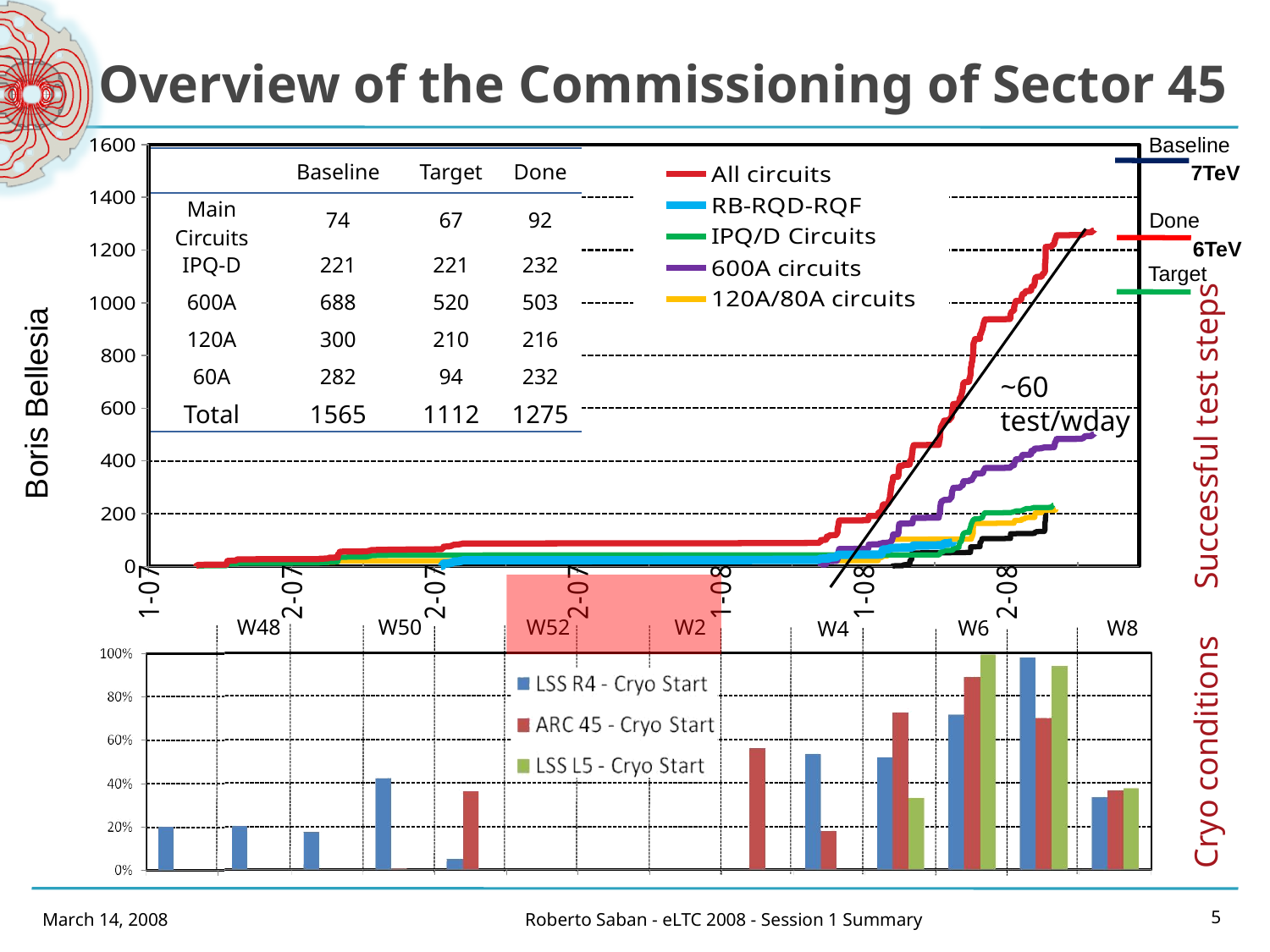
On the bottom chart (Cryo conditions), how many series does the legend list? 3 On the bottom chart (Cryo conditions), is the ARC 45 - Cryo Start value at W6 greater or less than 80%? greater On the top chart (Successful test steps), is the final value of the 600A circuits line greater or less than 400? greater On the top chart (Successful test steps), which series reaches the highest value at the right end of the chart? All circuits On the top chart (Successful test steps), do the lines rise or fall over time along the x axis? rise On the top chart (Successful test steps), is the final value of the All circuits line greater or less than 1200? greater On the top chart (Successful test steps), how many series does the legend list? 5 On the bottom chart (Cryo conditions), what kind of chart is it? bar chart On the top chart (Successful test steps), which series is plotted in red? All circuits On the bottom chart (Cryo conditions), at W6 which is larger, LSS R4 - Cryo Start or ARC 45 - Cryo Start? ARC 45 - Cryo Start On the bottom chart (Cryo conditions), how many week labels (W48 to W8) are shown along the x axis? 7 On the top chart (Successful test steps), what kind of chart is it? line chart